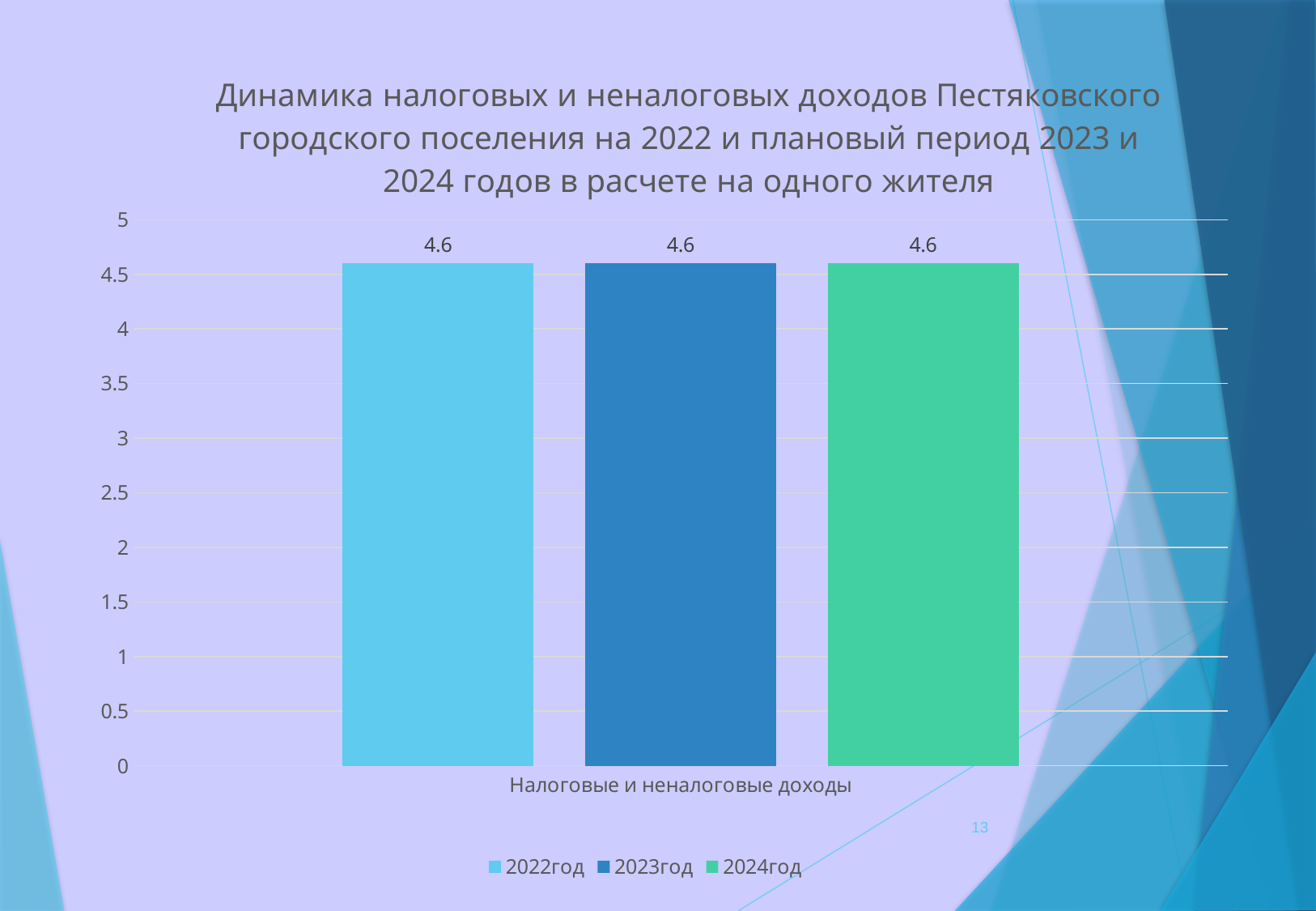
Is the value for 2024год greater or less than 5? less What is the label of the category on the x axis? Налоговые и неналоговые доходы How many series does the legend list? 3 What kind of chart is shown on the slide? bar chart Which series is shown in green? 2024год Do the values rise, fall or stay the same from 2022год to 2024год? stay the same Is the value for 2023год greater or less than 4? greater How many categories are shown on the x axis? 1 What is the value for 2023год for Налоговые и неналоговые доходы? 4.6 What is the value for 2022год for Налоговые и неналоговые доходы? 4.6 What is the value for 2024год for Налоговые и неналоговые доходы? 4.6 What is the difference between the values for 2024год and 2022год? 0